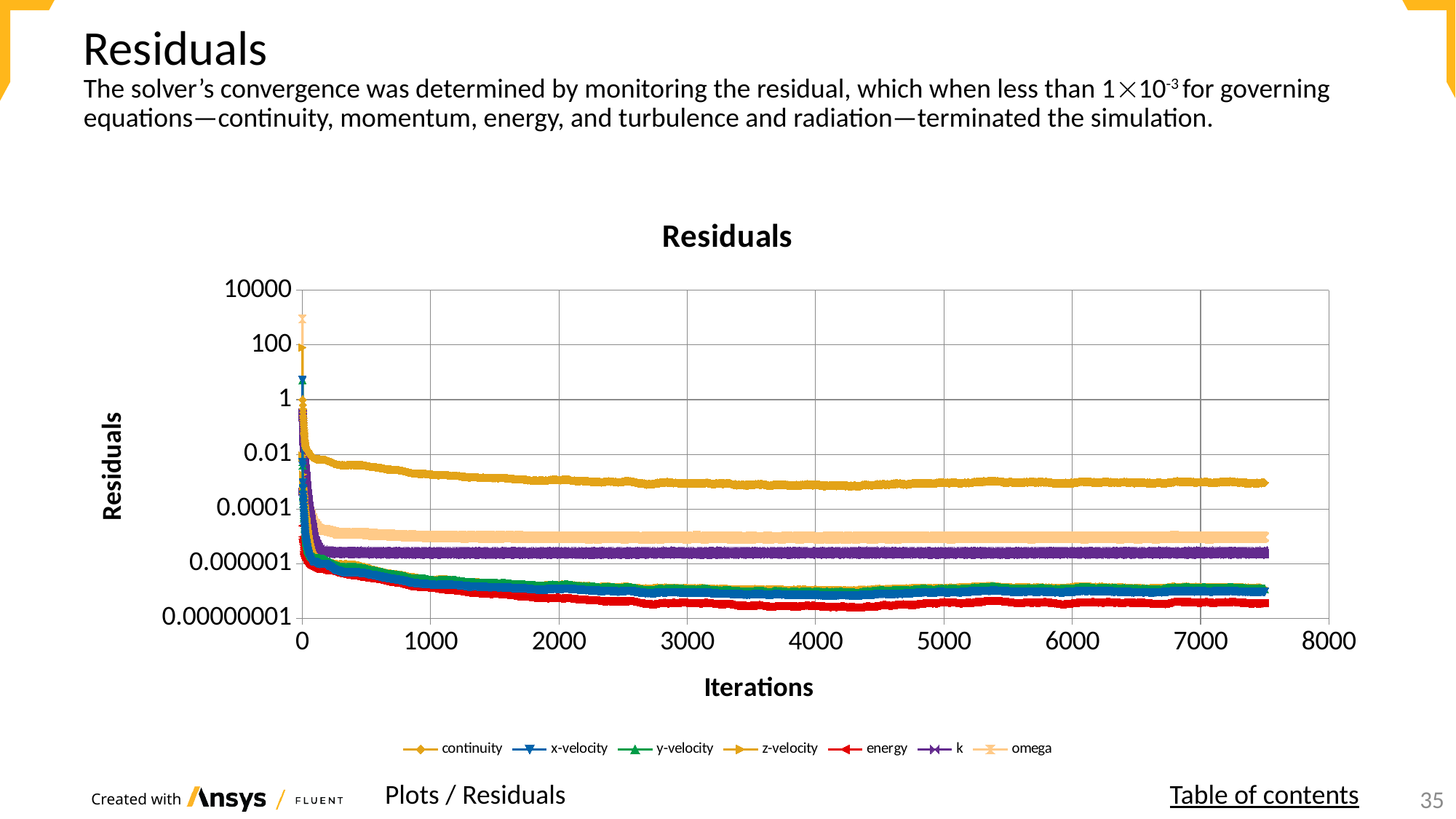
How many series does the legend of the Residuals chart list? 7 At around 5000 iterations, which series has the larger residual, continuity or omega? continuity Which series has the lowest residual value at the end of the iterations (around 7000)? energy What is the title of the chart? Residuals Is the omega residual at around 6000 iterations greater or less than 0.0001? less What is the label of the x axis of the chart? Iterations Which series has the highest residual value at the end of the iterations (around 7000)? continuity Is the energy residual at around 7000 iterations greater or less than 0.000001? less What kind of chart is shown on the slide? line chart At around 3000 iterations, which series has the larger residual, k or energy? k Is the continuity residual at around 7000 iterations greater or less than 0.0001? greater Do the residual values generally rise or fall as the number of iterations increases? fall